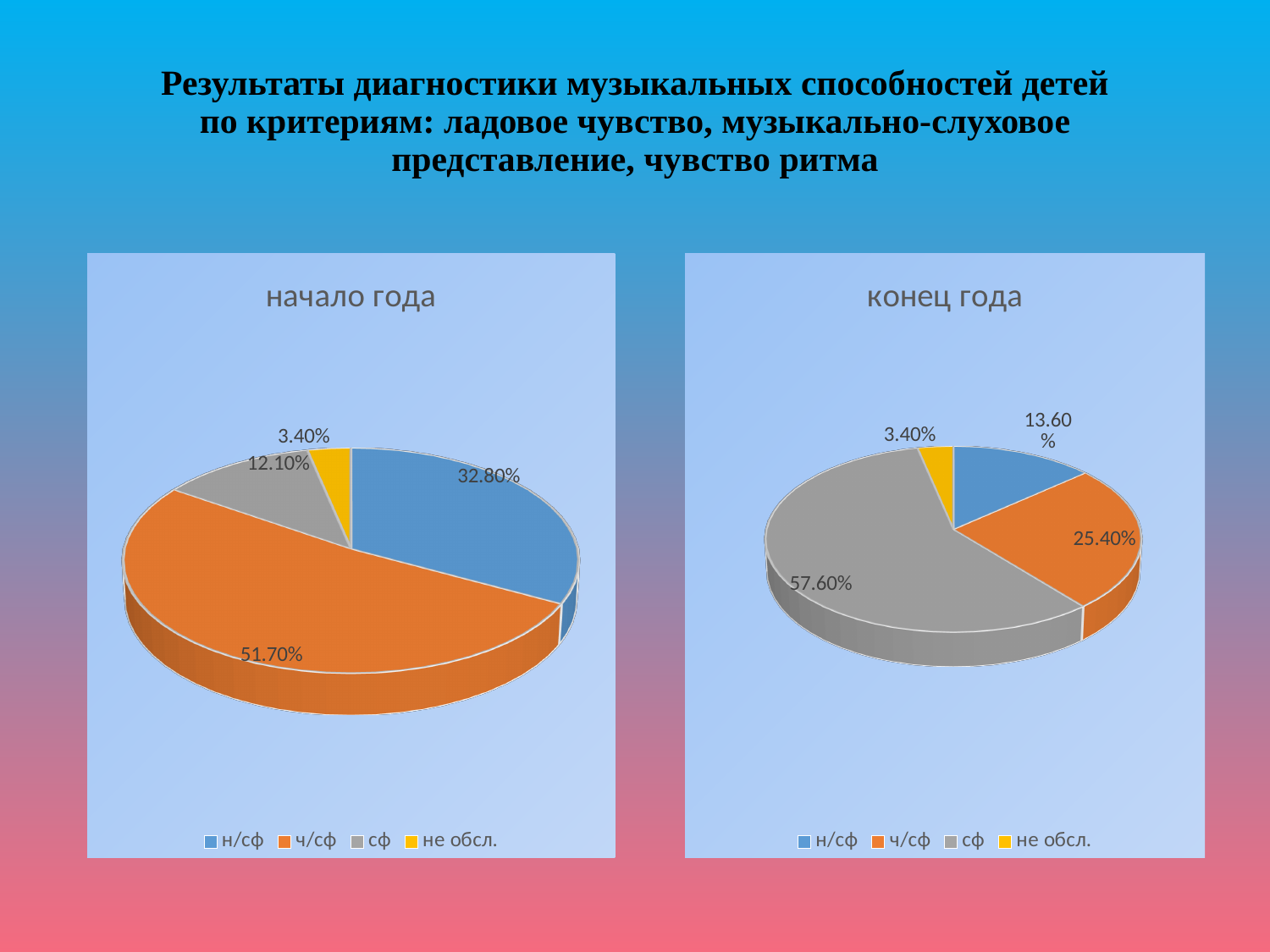
In the 'конец года' chart, what is the value for ч/сф? 25.40% In the 'конец года' chart, what is the value for сф? 57.60% In the 'конец года' chart, which category has the smallest slice? не обсл. In the 'начало года' chart, what is the value for ч/сф? 51.70% In the 'начало года' chart, what is the value for н/сф? 32.80% What is the difference between the сф value in the 'конец года' chart and the сф value in the 'начало года' chart? 45.50% In the 'начало года' chart, what is the difference between ч/сф and н/сф? 18.90% In the 'конец года' chart, which is larger: н/сф or ч/сф? ч/сф What is the title of the chart on the right side of the slide? конец года How many categories does the legend of the 'конец года' chart list? 4 What type of chart is the 'начало года' chart? pie chart In the 'начало года' chart, which category has the largest slice? ч/сф